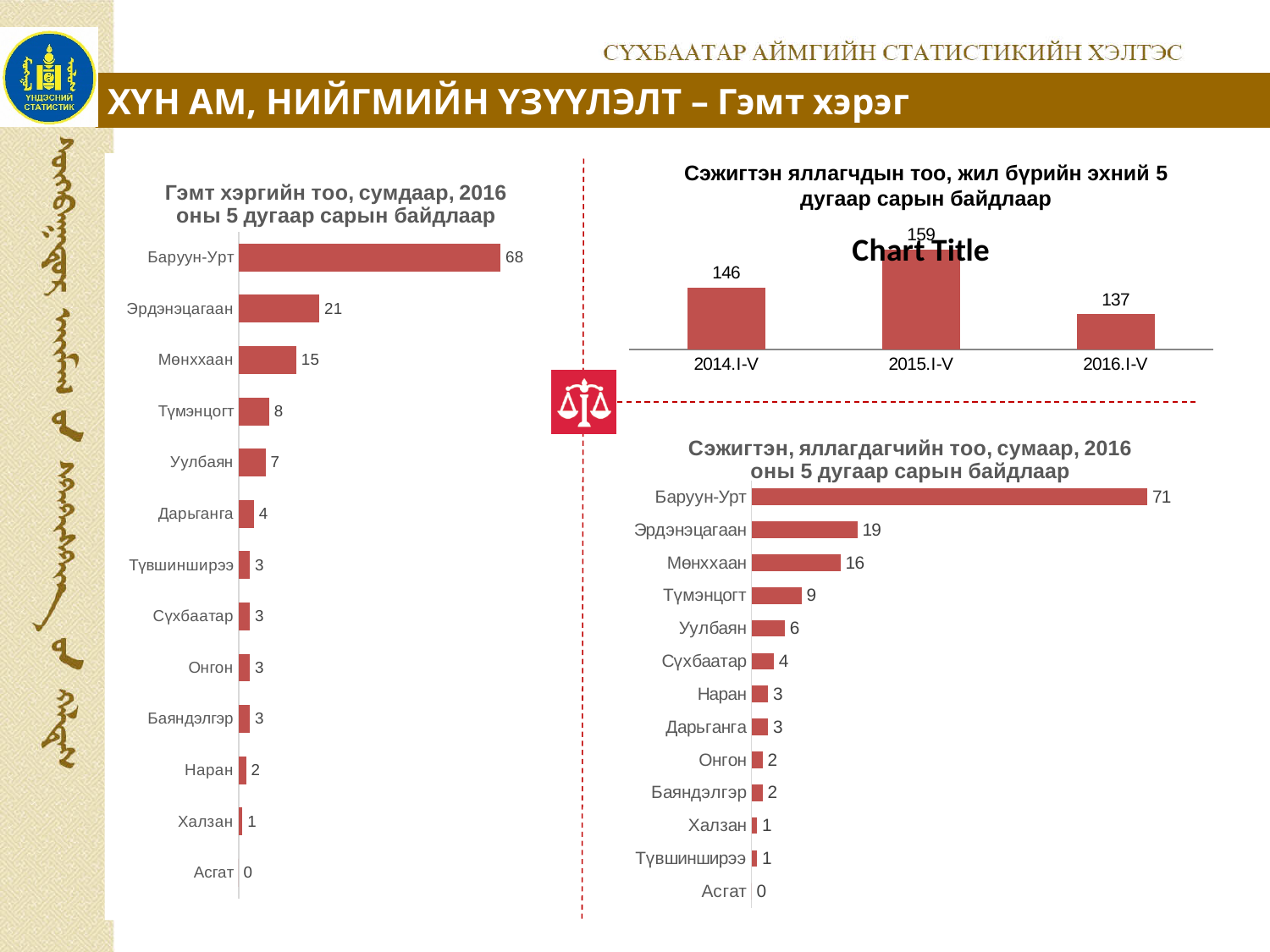
In the top right chart 'Сэжигтэн яллагчдын тоо', which period has the lowest value? 2016.I-V What kind of chart is the top right chart 'Сэжигтэн яллагчдын тоо'? Bar chart In the top right chart 'Сэжигтэн яллагчдын тоо', what is the difference between the values for 2014.I-V and 2016.I-V? 9 In the left chart 'Гэмт хэргийн тоо, сумдаар', what is the difference between the values for Эрдэнэцагаан and Мөнххаан? 6 In the left chart 'Гэмт хэргийн тоо, сумдаар', how many categories are shown? 13 In the left chart 'Гэмт хэргийн тоо, сумдаар', which category has the lowest value? Асгат In the bottom right chart 'Сэжигтэн, яллагдагчийн тоо, сумаар, 2016 оны 5 дугаар сарын байдлаар', what is the value for Түмэнцогт? 9 In the top right chart 'Сэжигтэн яллагчдын тоо, жил бүрийн эхний 5 дугаар сарын байдлаар', what is the value for 2015.I-V? 159 In the bottom right chart 'Сэжигтэн, яллагдагчийн тоо, сумаар', what is the difference between the values for Баруун-Урт and Эрдэнэцагаан? 52 In the left chart 'Гэмт хэргийн тоо, сумдаар, 2016 оны 5 дугаар сарын байдлаар', what is the value for Баруун-Урт? 68 In the left chart 'Гэмт хэргийн тоо, сумдаар', which category has the highest value? Баруун-Урт In the bottom right chart 'Сэжигтэн, яллагдагчийн тоо, сумаар', which is larger, the value for Уулбаян or the value for Сүхбаатар? Уулбаян